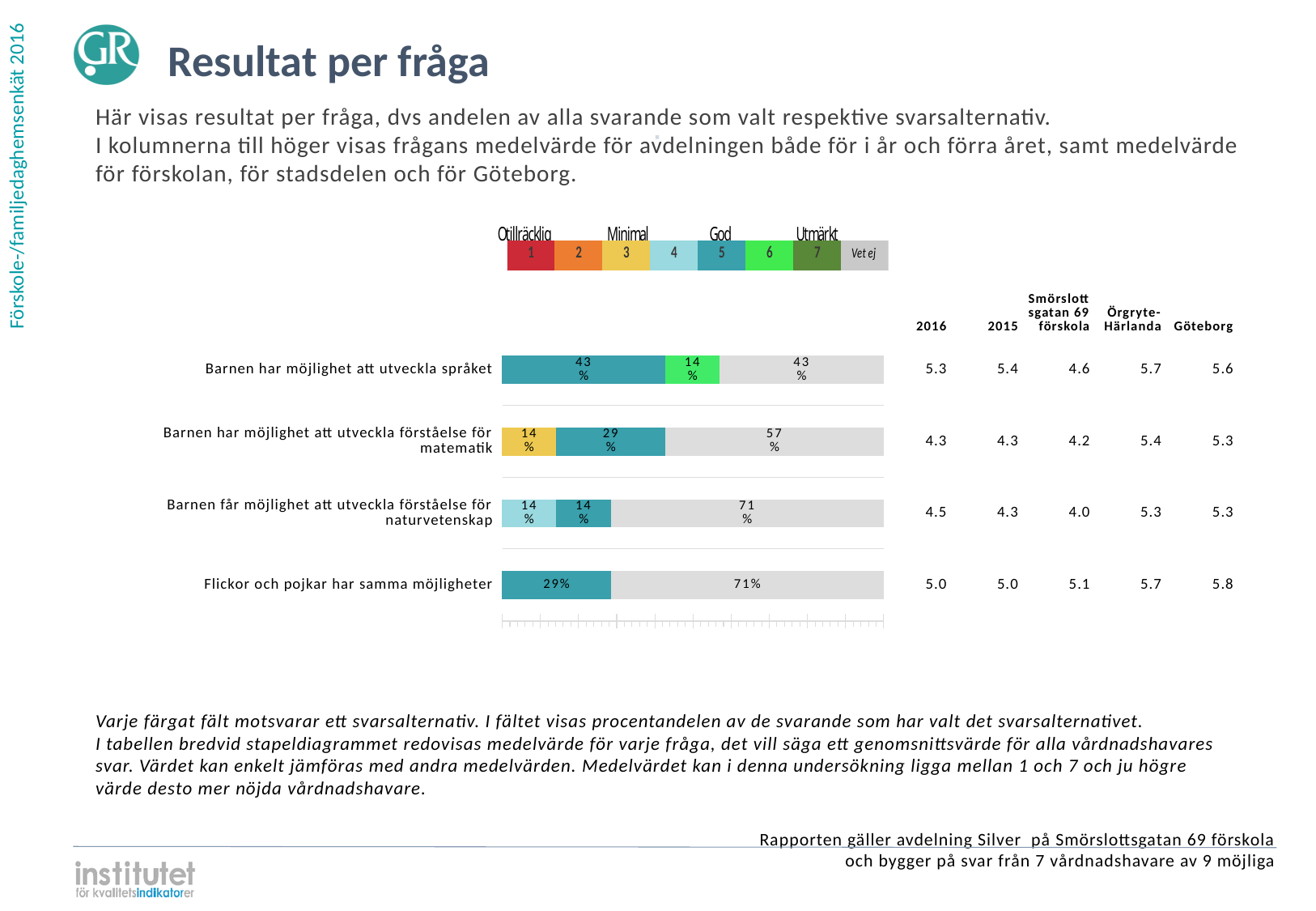
Which question has the largest 'Vet ej' (grey) share, tied with 'Flickor och pojkar har samma möjligheter'? Barnen får möjlighet att utveckla förståelse för naturvetenskap What kind of chart is shown on the slide? bar chart Which is larger: the option 5 (teal) share for 'Barnen har möjlighet att utveckla språket' or for 'Barnen har möjlighet att utveckla förståelse för matematik'? Barnen har möjlighet att utveckla språket What percentage of respondents chose 'Vet ej' (grey) for 'Barnen har möjlighet att utveckla språket'? 43% Which question has the smallest 'Vet ej' (grey) share? Barnen har möjlighet att utveckla språket What percentage of respondents chose option 6 (green) for 'Barnen har möjlighet att utveckla språket'? 14% How many response options does the legend above the chart list, including 'Vet ej'? 8 What percentage of respondents chose option 5 (teal) for 'Flickor och pojkar har samma möjligheter'? 29% What is the 2016 mean value shown for 'Barnen får möjlighet att utveckla förståelse för naturvetenskap'? 4.5 What is the Göteborg mean value shown for 'Flickor och pojkar har samma möjligheter'? 5.8 How many questions (categories) are plotted in the bar chart? 4 What is the difference between the 'Vet ej' share for 'Barnen har möjlighet att utveckla förståelse för matematik' (57%) and for 'Barnen har möjlighet att utveckla språket' (43%)? 14%